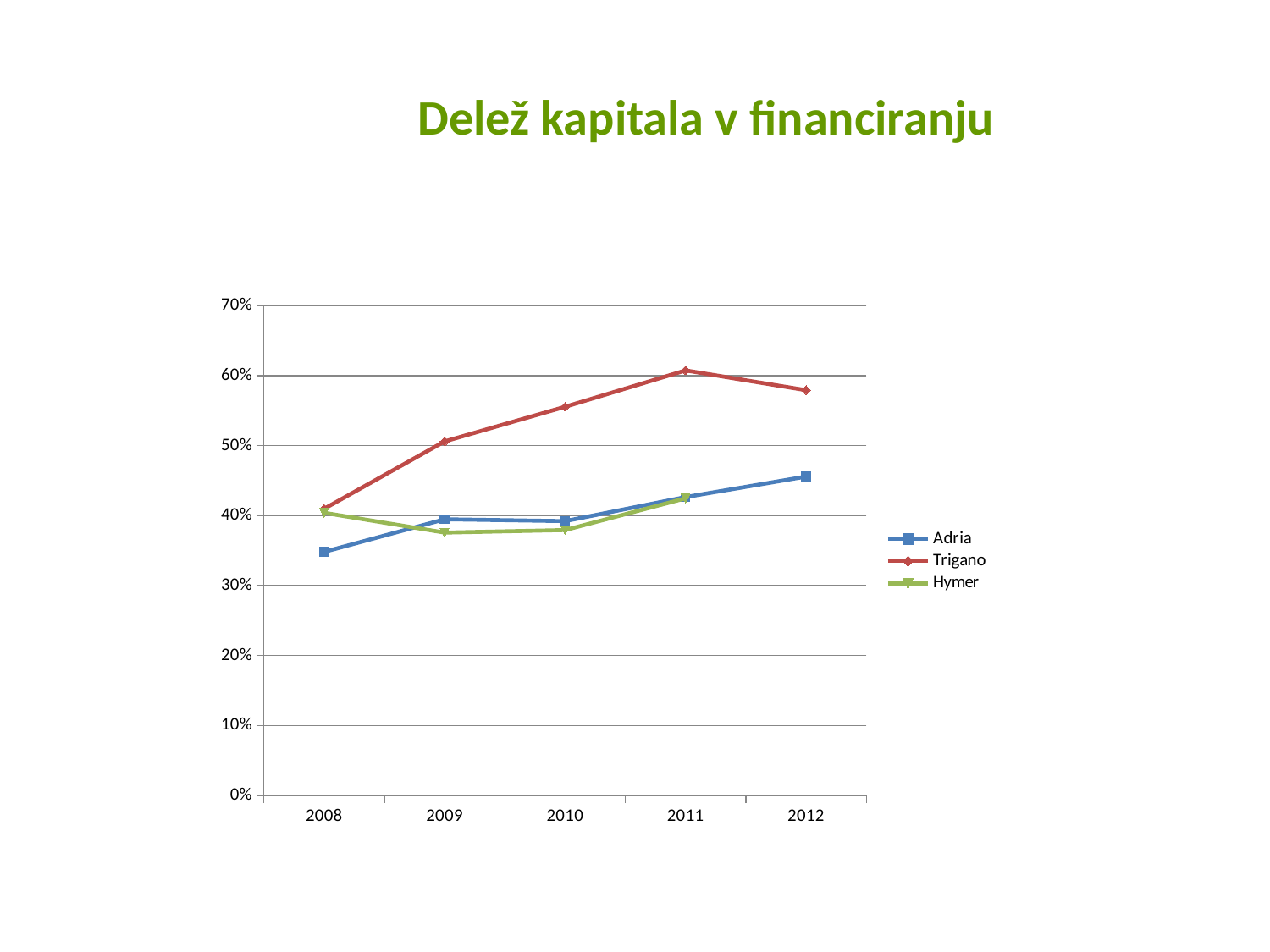
In which year is the value for Adria lowest? 2008 Is the value for Adria in 2008 greater or less than 40%? less What is the title of the chart? Delež kapitala v financiranju How many years are shown on the x axis? 5 Is the value for Trigano in 2010 greater or less than 50%? greater In 2009, which is larger: the value for Adria or the value for Hymer? Adria What kind of chart is shown on the slide? line chart Does the value for Trigano rise or fall from 2008 to 2011? rise Which series has the highest value in 2012? Trigano In which year does Trigano reach its highest value? 2011 How many series does the legend list? 3 Is the value for Hymer in 2009 greater or less than 40%? less